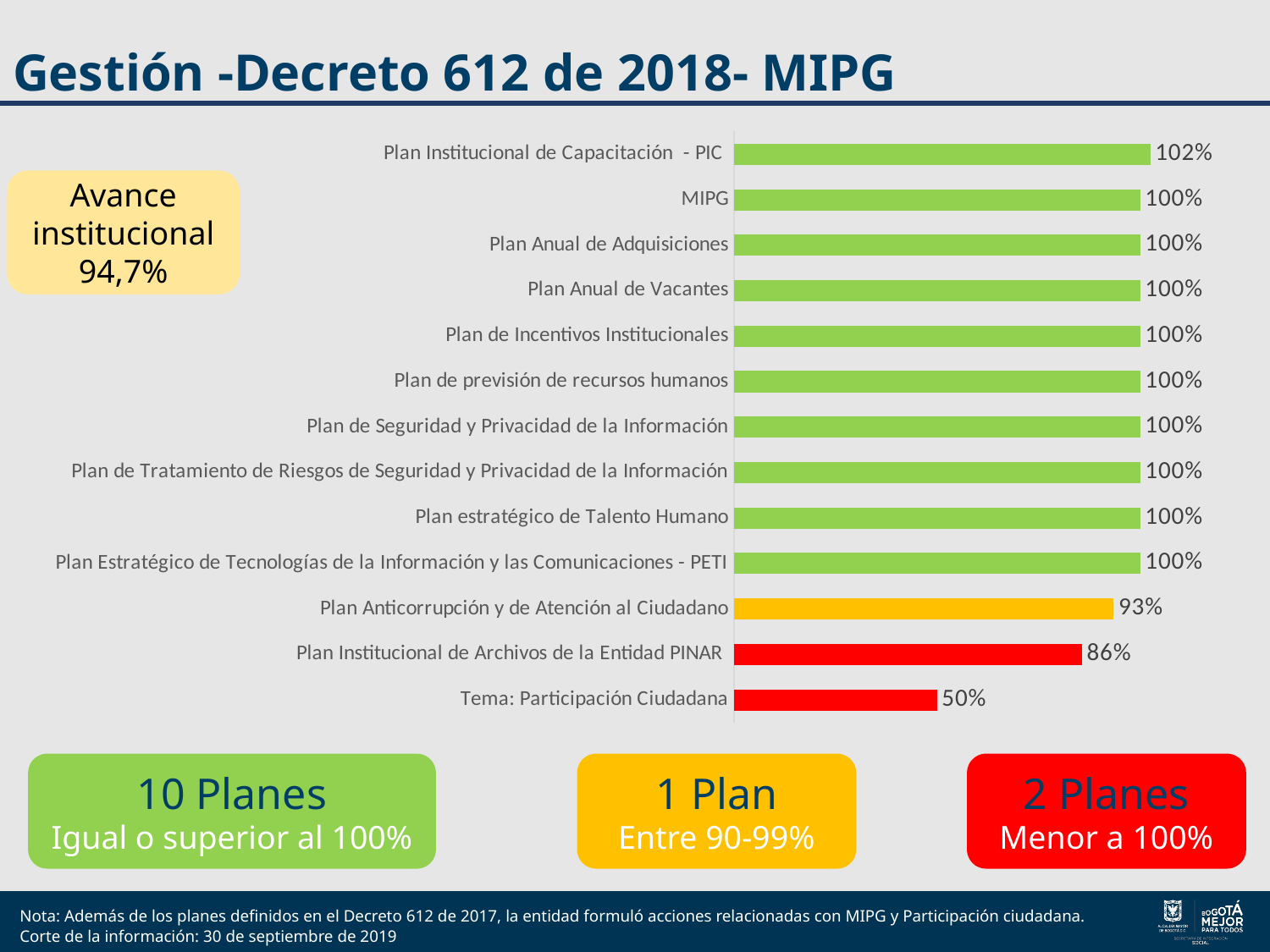
What is the value for Tema: Participación Ciudadana? 50% What colour is the bar for Plan Anticorrupción y de Atención al Ciudadano? Yellow What is the value for Plan Institucional de Archivos de la Entidad PINAR? 86% What is the difference between the values for Plan Institucional de Capacitación - PIC and Tema: Participación Ciudadana? 52% What is the difference between the values for Plan Anticorrupción y de Atención al Ciudadano and Plan Institucional de Archivos de la Entidad PINAR? 7% Which is larger, the value for MIPG or the value for Plan Anticorrupción y de Atención al Ciudadano? MIPG What is the value for Plan Institucional de Capacitación - PIC? 102% How many categories are shown in the chart? 13 Which category has the highest value? Plan Institucional de Capacitación - PIC What is the value for Plan Anticorrupción y de Atención al Ciudadano? 93% What kind of chart is shown on the slide? Bar chart Which category has the lowest value? Tema: Participación Ciudadana